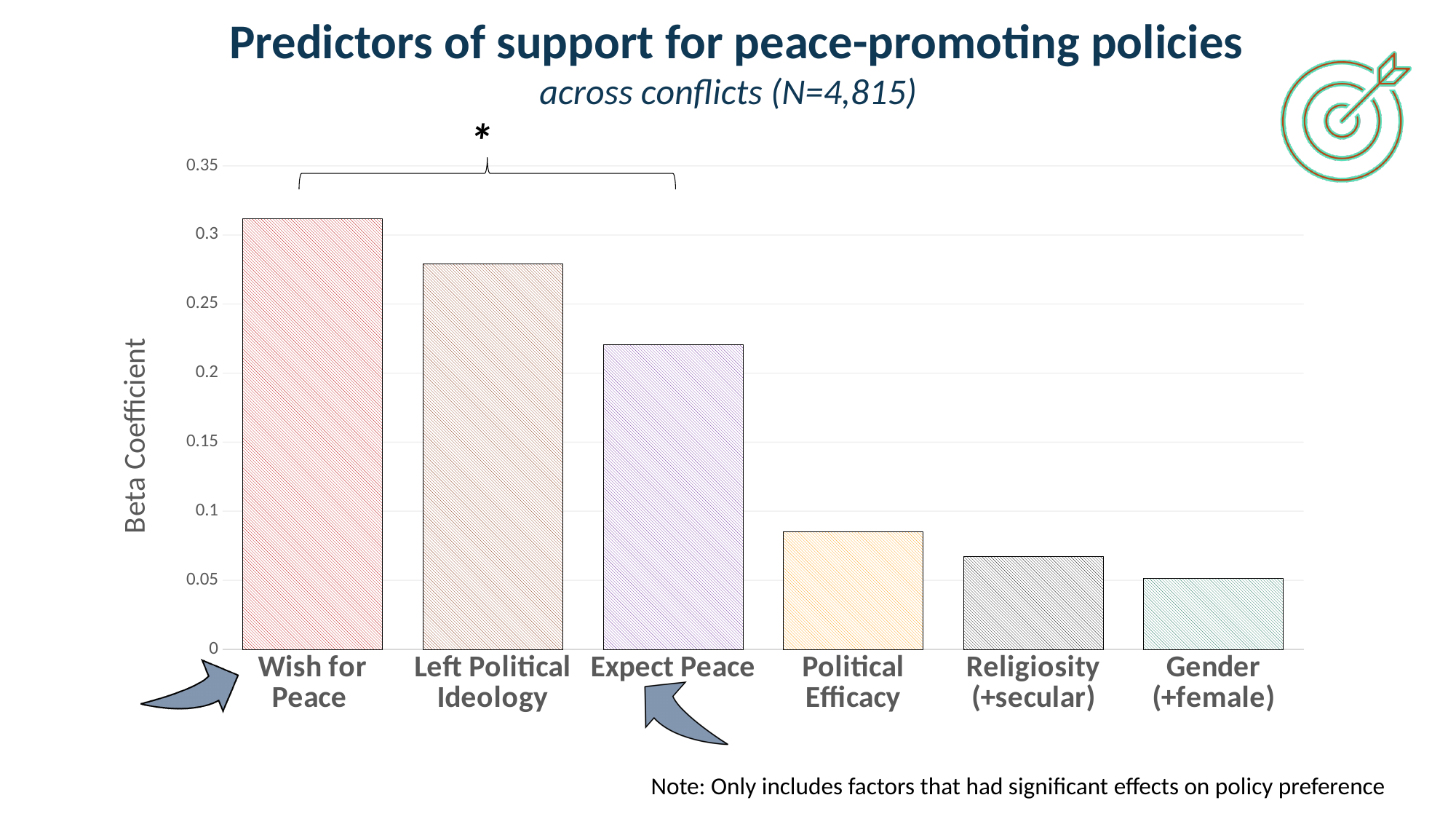
Is the beta coefficient for Wish for Peace greater or less than 0.25? greater Do the beta coefficients rise or fall moving from left to right across the categories? fall What is the label on the vertical axis of the chart? Beta Coefficient What kind of chart is shown on the slide? bar chart How many predictors (categories) are plotted on the chart? 6 Which predictor has the highest beta coefficient? Wish for Peace Which has a larger beta coefficient, Religiosity (+secular) or Gender (+female)? Religiosity (+secular) Is the beta coefficient for Political Efficacy greater or less than 0.1? less Is the beta coefficient for Left Political Ideology greater or less than 0.25? greater Which has a larger beta coefficient, Wish for Peace or Left Political Ideology? Wish for Peace Which predictor has the lowest beta coefficient? Gender (+female)